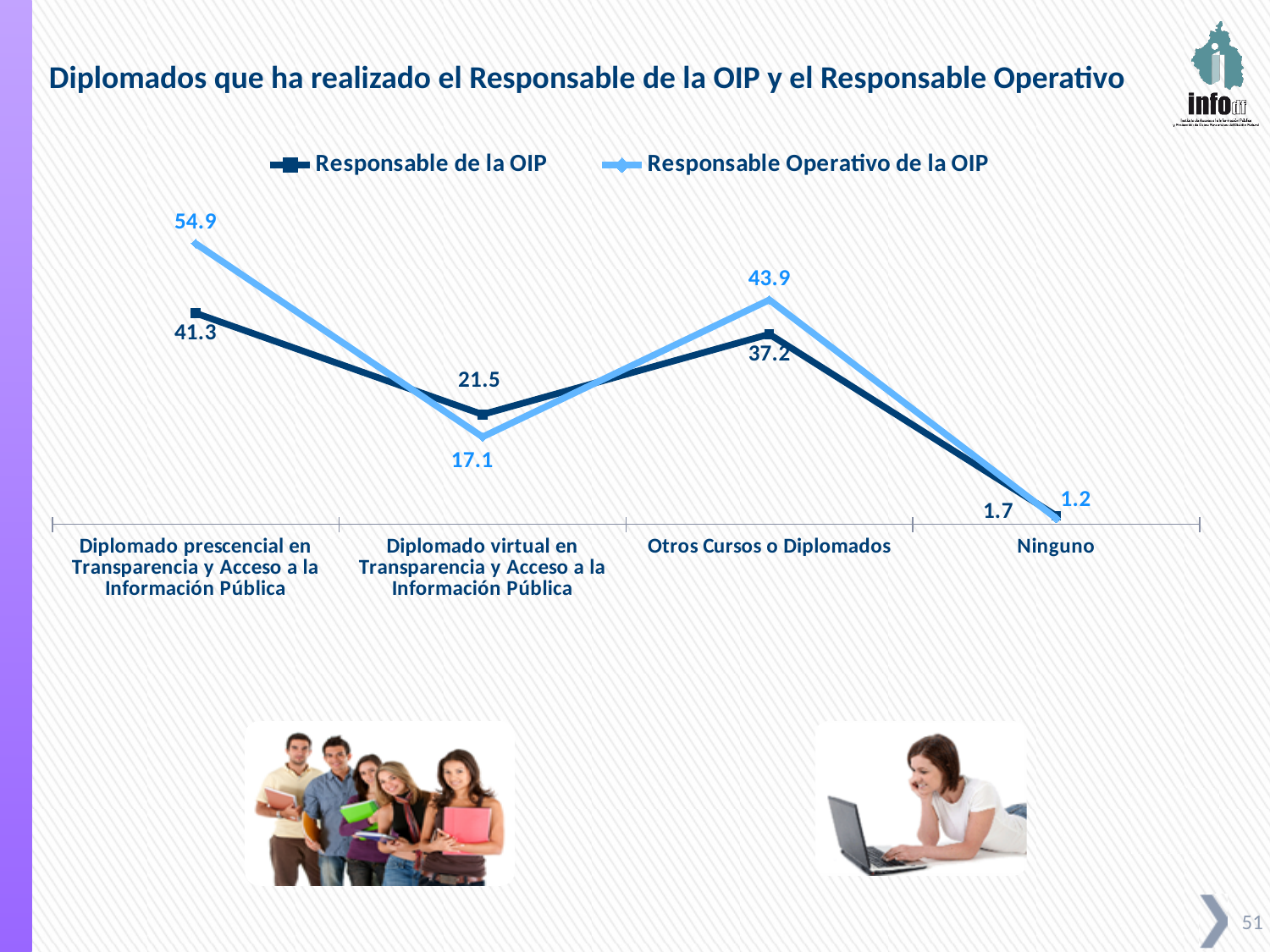
What is the value for Responsable de la OIP for Ninguno? 1.7 How many series does the legend list? 2 What is the title of the chart? Diplomados que ha realizado el Responsable de la OIP y el Responsable Operativo What is the value for Responsable de la OIP for Diplomado prescencial en Transparencia y Acceso a la Información Pública? 41.3 What is the value for Responsable Operativo de la OIP for Diplomado virtual en Transparencia y Acceso a la Información Pública? 17.1 What is the value for Responsable Operativo de la OIP for Otros Cursos o Diplomados? 43.9 Which category has the highest value for Responsable Operativo de la OIP? Diplomado prescencial en Transparencia y Acceso a la Información Pública For Diplomado virtual en Transparencia y Acceso a la Información Pública, which series has the larger value? Responsable de la OIP What is the difference between the Responsable Operativo de la OIP and Responsable de la OIP values for Diplomado prescencial en Transparencia y Acceso a la Información Pública? 13.6 Which category has the lowest value for Responsable de la OIP? Ninguno How many categories are shown on the x axis? 4 What kind of chart is shown on the slide? Line chart